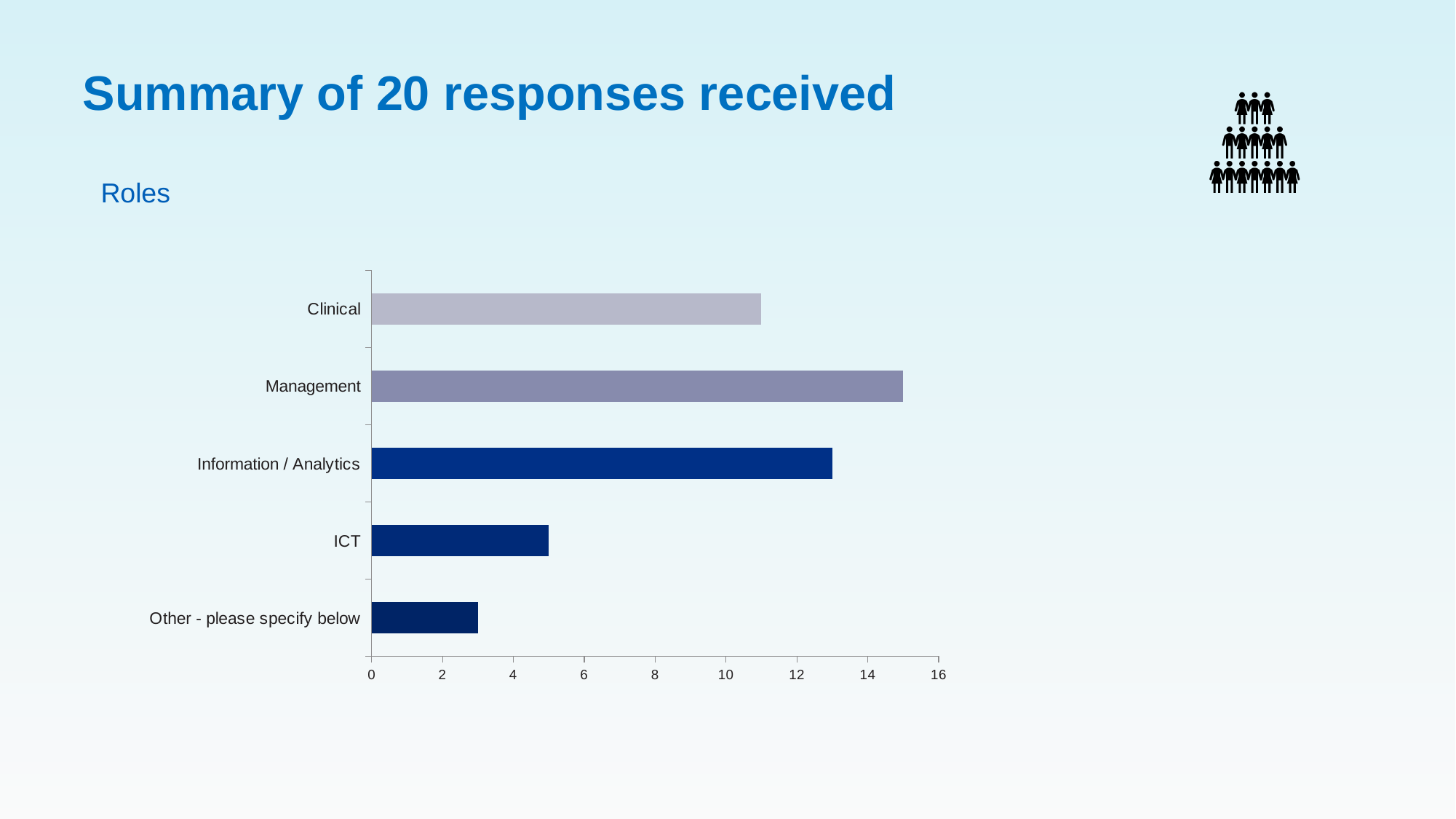
Is the value for Management greater or less than 14? greater Is the value for ICT greater or less than 6? less Is the value for Other - please specify below greater or less than 4? less What kind of chart is shown on the slide? bar chart Which is larger, the value for Clinical or the value for Information / Analytics? Information / Analytics How many role categories are plotted in the chart? 5 Which is larger, the value for ICT or the value for Other - please specify below? ICT Which role has the lowest number of responses? Other - please specify below What is the maximum value shown on the horizontal axis? 16 Which role has the highest number of responses? Management